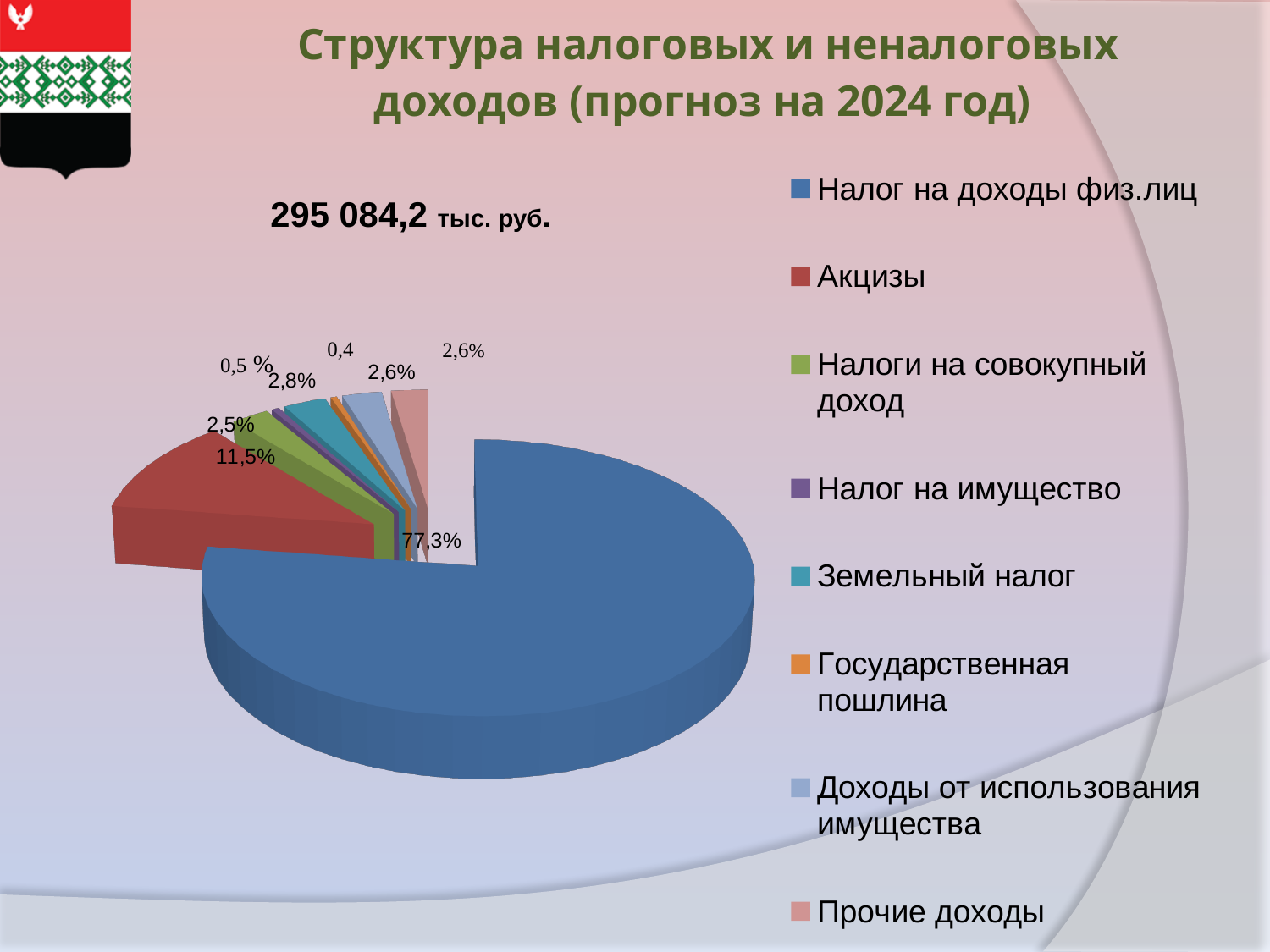
How many percentage points larger is the share of Налог на доходы физ.лиц than the share of Акцизы? 65,8 Which category has the largest slice of the pie? Налог на доходы физ.лиц What share of the pie does Налог на доходы физ.лиц have? 77,3% How many categories does the legend list? 8 Which category has the second largest slice of the pie? Акцизы Which is larger, the slice for Акцизы or the slice for Налоги на совокупный доход? Акцизы What kind of chart is shown on the slide? pie chart What total amount is printed above the pie chart? 295 084,2 тыс. руб. What colour is the slice for Прочие доходы? pink What share of the pie does Земельный налог have? 2,8% What share of the pie does Налоги на совокупный доход have? 2,5% What share of the pie does Акцизы have? 11,5%